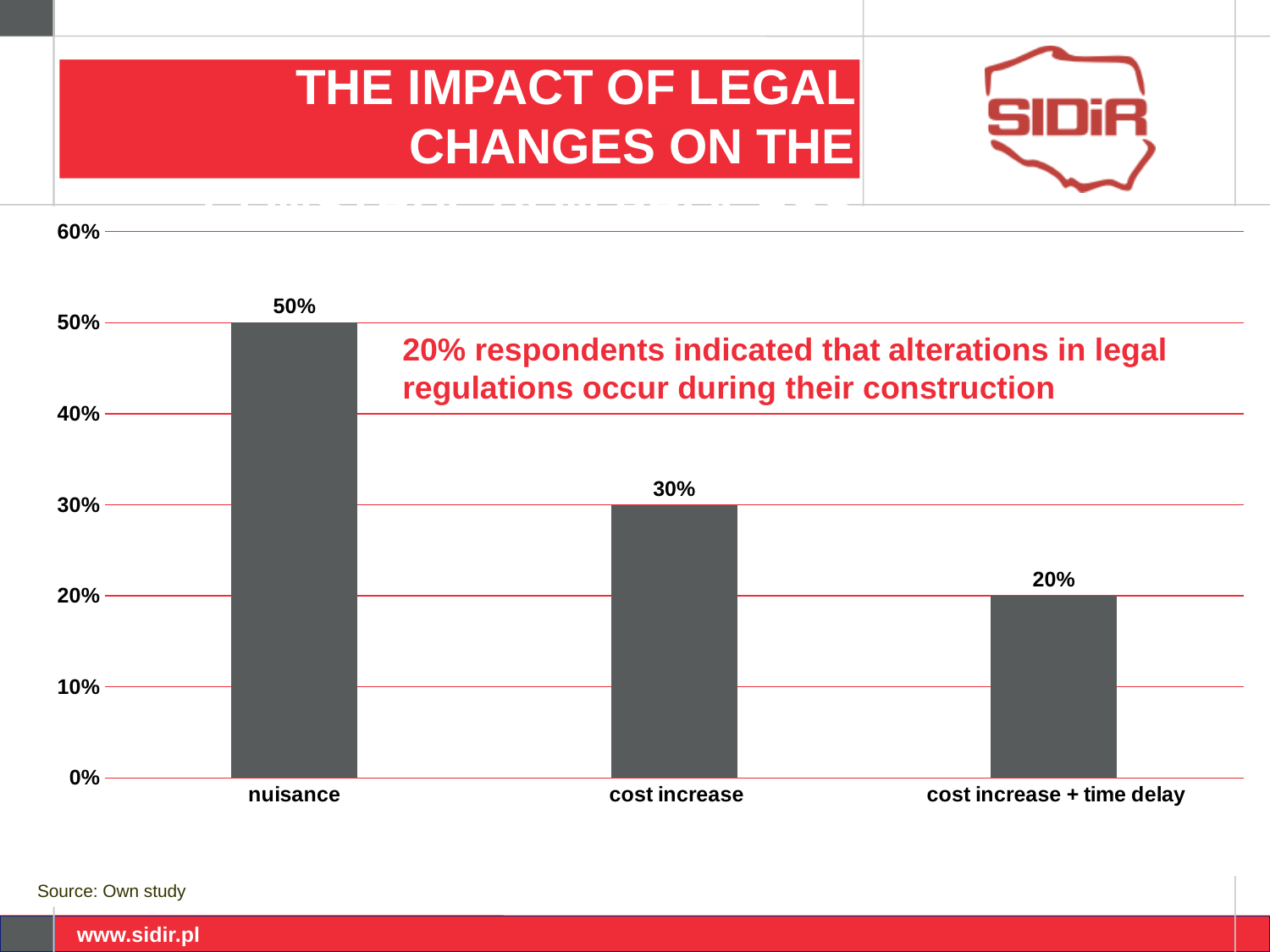
Which category has the highest value? nuisance What is the value for "nuisance"? 50% Is the value for "nuisance" greater or less than 40%? greater What is the difference between the values for "cost increase" and "cost increase + time delay"? 10% What is the value for "cost increase"? 30% Which is larger, the value for "cost increase" or the value for "cost increase + time delay"? cost increase What is the difference between the values for "nuisance" and "cost increase"? 20% What kind of chart is shown on the slide? bar chart Do the values rise or fall from left to right along the x axis? fall Which category has the lowest value? cost increase + time delay How many categories are shown on the x axis? 3 What is the value for "cost increase + time delay"? 20%